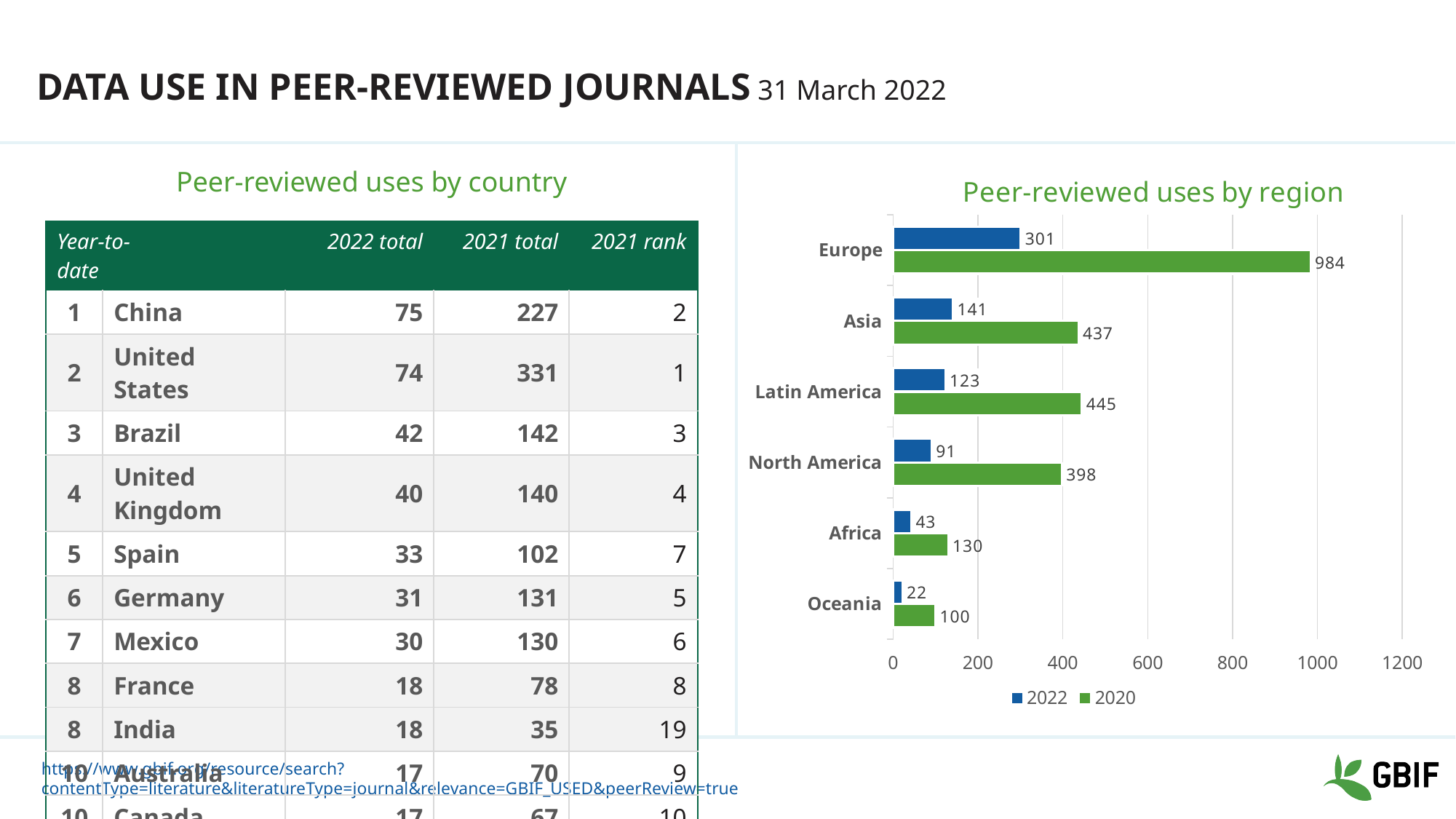
In the 'Peer-reviewed uses by region' chart, what is the 2022 value for Asia? 141 In the 'Peer-reviewed uses by region' chart, which is larger: the 2020 value for Asia or the 2020 value for Latin America? Latin America What kind of chart is 'Peer-reviewed uses by region'? Bar chart In the 'Peer-reviewed uses by region' chart, what is the 2020 value for North America? 398 In the 'Peer-reviewed uses by region' chart, is the 2020 value for Europe greater or less than 800? greater How many series does the legend of the 'Peer-reviewed uses by region' chart list? 2 In the 'Peer-reviewed uses by region' chart, which region has the highest 2020 value? Europe How many regions are shown in the 'Peer-reviewed uses by region' chart? 6 In the 'Peer-reviewed uses by region' chart, what is the difference between the 2020 and 2022 values for Africa? 87 In the 'Peer-reviewed uses by region' chart, which colour represents the 2022 series? Blue In the 'Peer-reviewed uses by region' chart, what is the 2020 value for Europe? 984 In the 'Peer-reviewed uses by region' chart, which region has the lowest 2022 value? Oceania